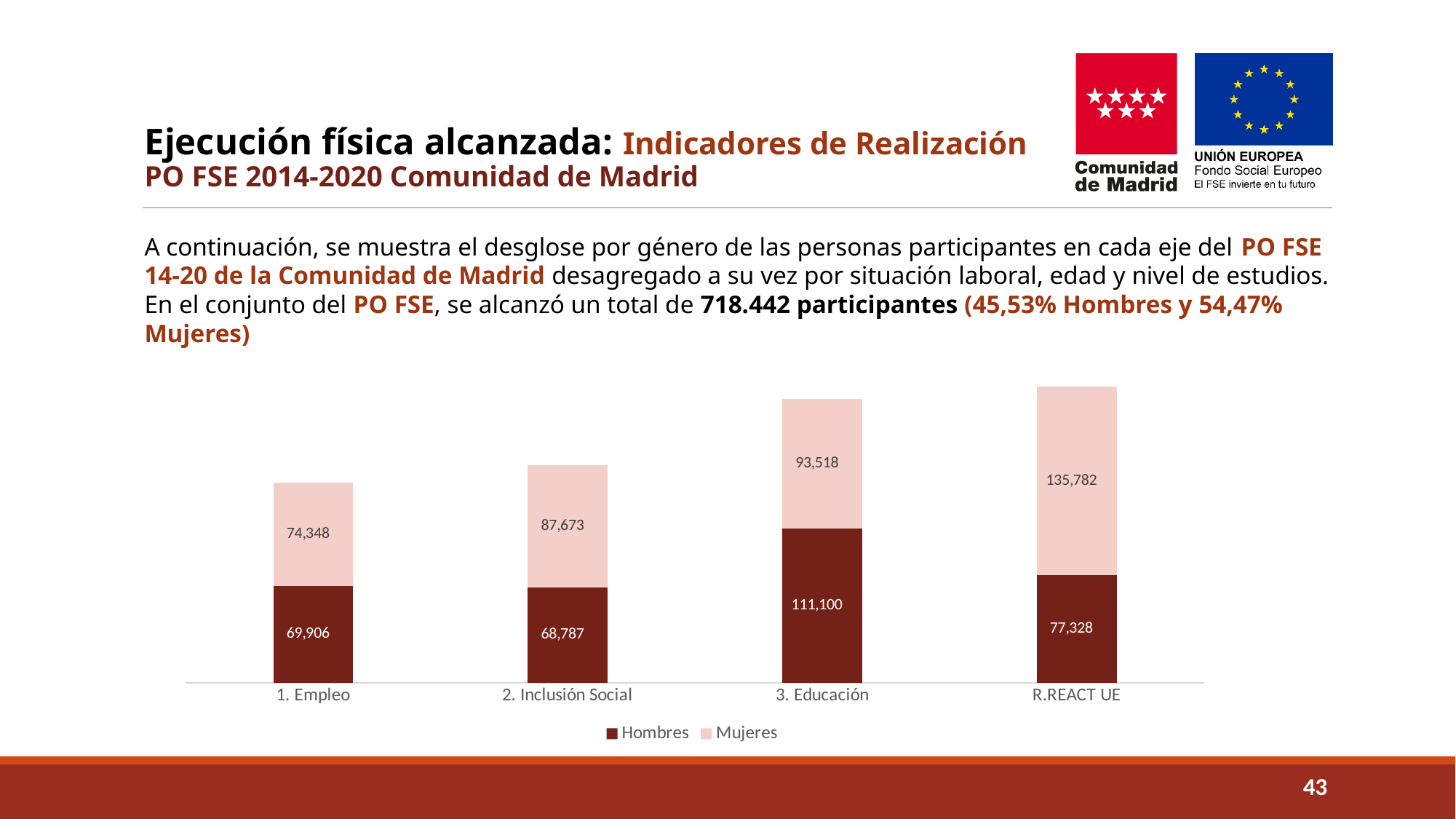
What is the Mujeres value for 1. Empleo? 74,348 What is the Hombres value for 2. Inclusión Social? 68,787 Which category has the lowest Mujeres value? 1. Empleo What kind of chart is shown on the slide? Stacked bar chart Which category has the highest Hombres value? 3. Educación Which is larger for R.REACT UE, the Hombres value or the Mujeres value? Mujeres How many series does the legend list? 2 What is the total of the stacked bar for 1. Empleo? 144,254 How many categories are shown on the x axis? 4 What is the Mujeres value for R.REACT UE? 135,782 What is the Hombres value for 3. Educación? 111,100 What is the difference between the Hombres and Mujeres values for 3. Educación? 17,582